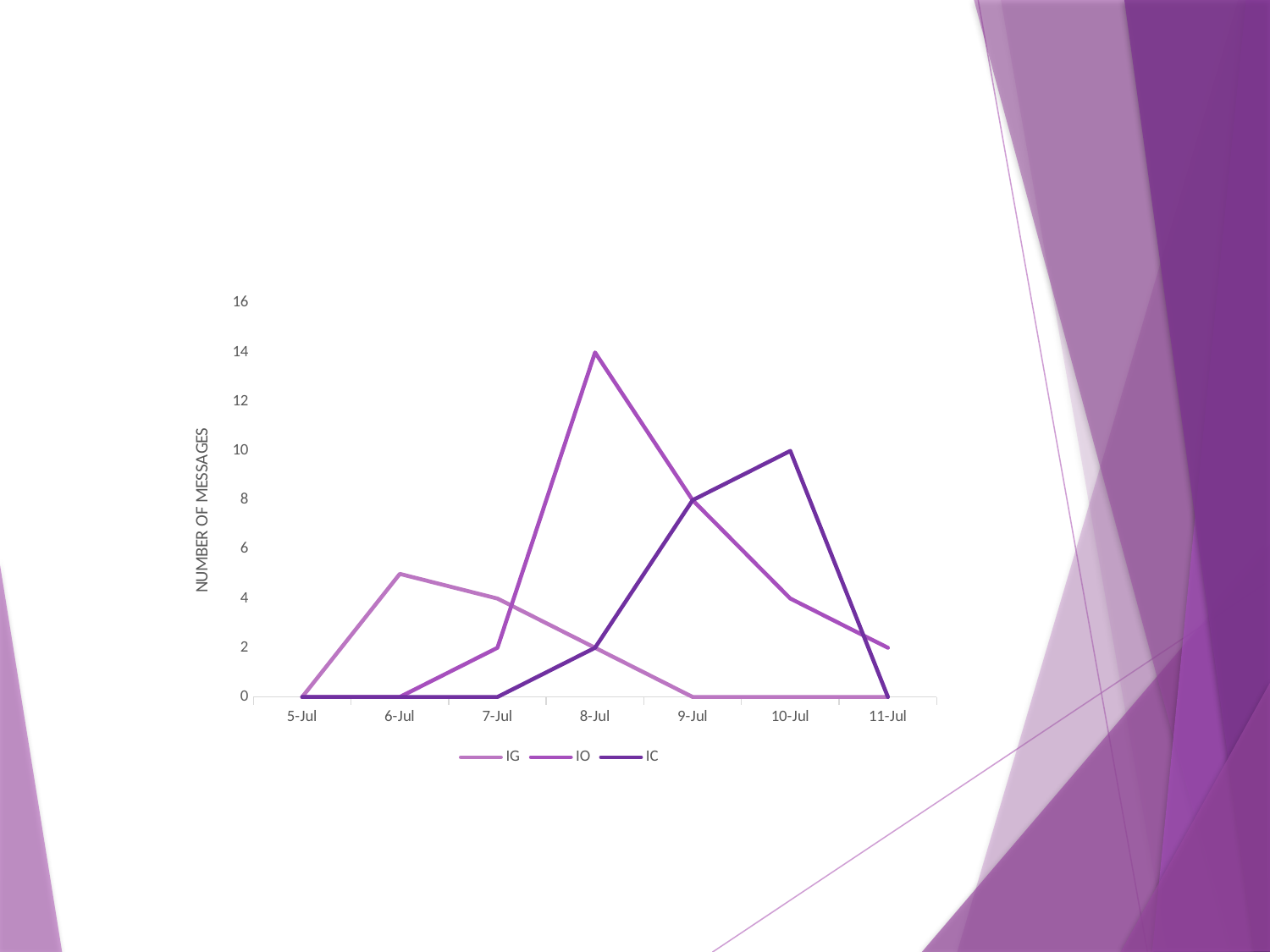
Is the value for IG on 6-Jul greater or less than 4? greater What is the value for IC on 10-Jul? 10 What is the value for IO on 8-Jul? 14 On 10-Jul, which series has the larger value, IC or IO? IC Does the IC series rise or fall from 10-Jul to 11-Jul? fall What kind of chart is shown on the slide? line chart On which date does the IC series reach its highest value? 10-Jul On which date does the IO series reach its highest value? 8-Jul What is the value for IO on 9-Jul? 8 What is the title of the vertical axis? NUMBER OF MESSAGES How many dates are plotted along the x axis? 7 How many series does the legend list? 3